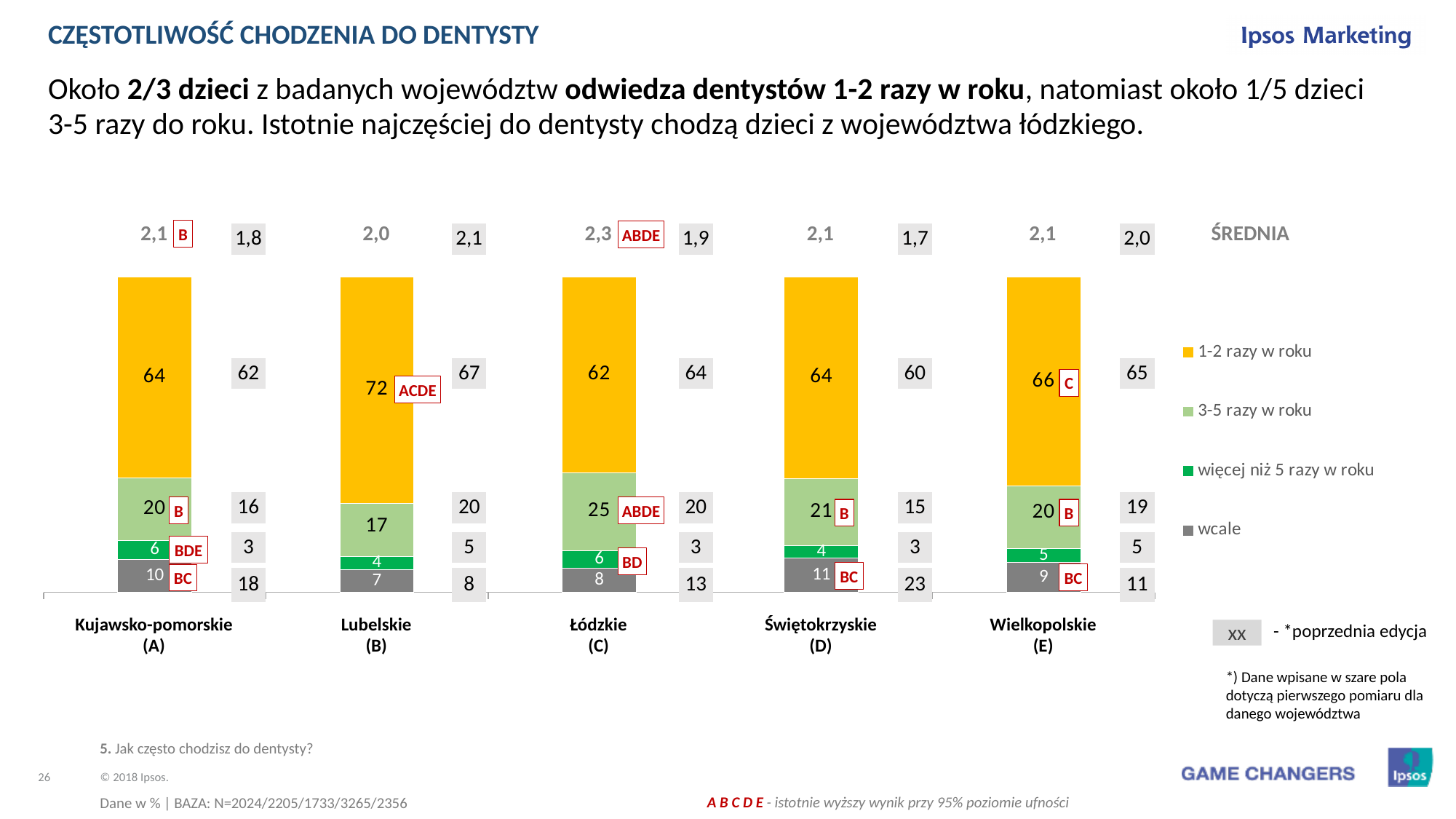
What is the value for 'więcej niż 5 razy w roku' for Świętokrzyskie (D)? 4 Which voivodeship has the lowest value for 'wcale'? Lubelskie (B) Which voivodeship has the highest value for '1-2 razy w roku'? Lubelskie (B) How many series does the legend list? 4 How many voivodeships are shown on the x axis of the chart? 5 What is the 'ŚREDNIA' (mean) value shown above the bar for Łódzkie (C)? 2,3 What is the difference between the '1-2 razy w roku' values for Lubelskie (B) and Łódzkie (C)? 10 What kind of chart is shown on the slide? Stacked bar chart What is the value for 'wcale' for Kujawsko-pomorskie (A)? 10 What is the value for '1-2 razy w roku' for Lubelskie (B)? 72 Which is larger: the '3-5 razy w roku' value for Kujawsko-pomorskie (A) or for Lubelskie (B)? Kujawsko-pomorskie (A) What is the value for '3-5 razy w roku' for Łódzkie (C)? 25